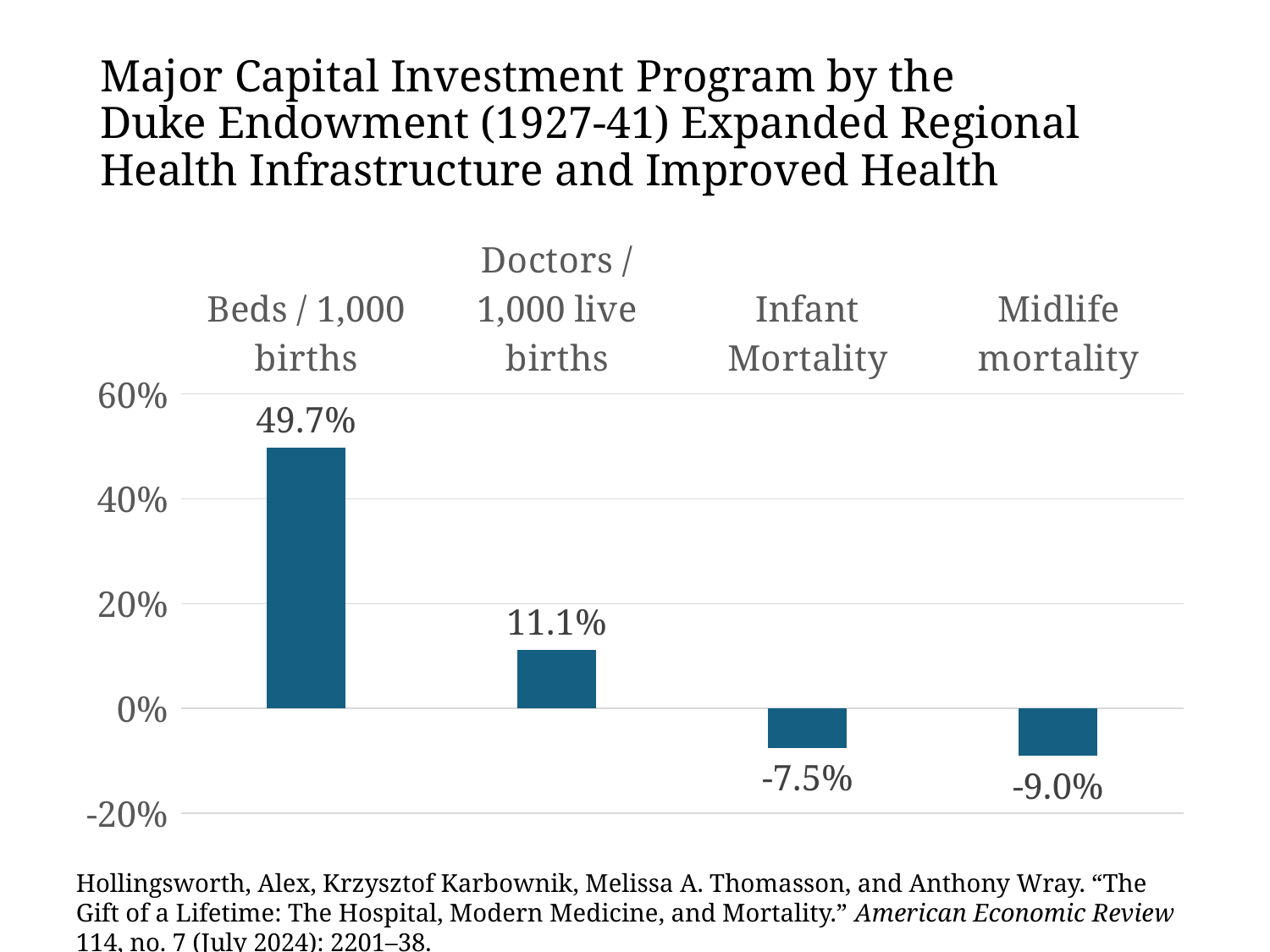
Which category has the highest value? Beds / 1,000 births What kind of chart is shown on the slide? bar chart What is the value for Beds / 1,000 births? 49.7% Which is larger, the value for Doctors / 1,000 live births or the value for Infant Mortality? Doctors / 1,000 live births Which category has the lowest value? Midlife mortality How many categories have negative values? 2 What is the value for Doctors / 1,000 live births? 11.1% How many categories are shown in the chart? 4 What is the value for Infant Mortality? -7.5% What is the difference between the values for Beds / 1,000 births and Doctors / 1,000 live births? 38.6 percentage points What is the value for Midlife mortality? -9.0% Is the value for Beds / 1,000 births greater or less than 40%? greater